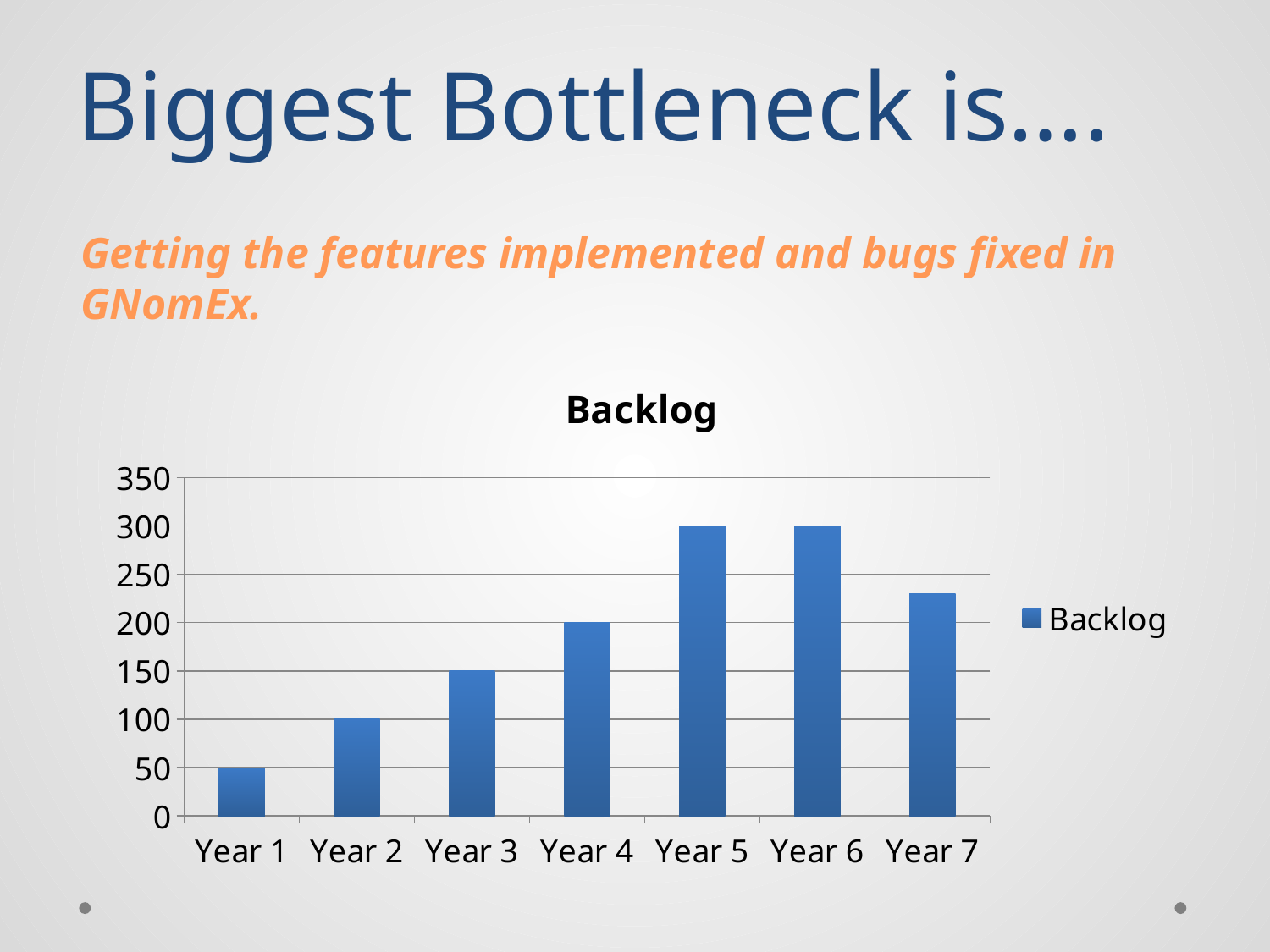
Do the Backlog values rise or fall from Year 1 to Year 5? rise What is the Backlog value for Year 1? 50 Which year has the lowest Backlog value? Year 1 Is the Backlog value for Year 7 greater or less than 250? less How many years are shown on the x axis of the Backlog chart? 7 Which has a larger Backlog value, Year 7 or Year 4? Year 7 What is the Backlog value for Year 5? 300 Is the Backlog value for Year 7 greater or less than 200? greater How many series does the legend of the Backlog chart list? 1 What is the difference between the Backlog values for Year 4 and Year 1? 150 What kind of chart is the Backlog chart? bar chart What is the Backlog value for Year 4? 200